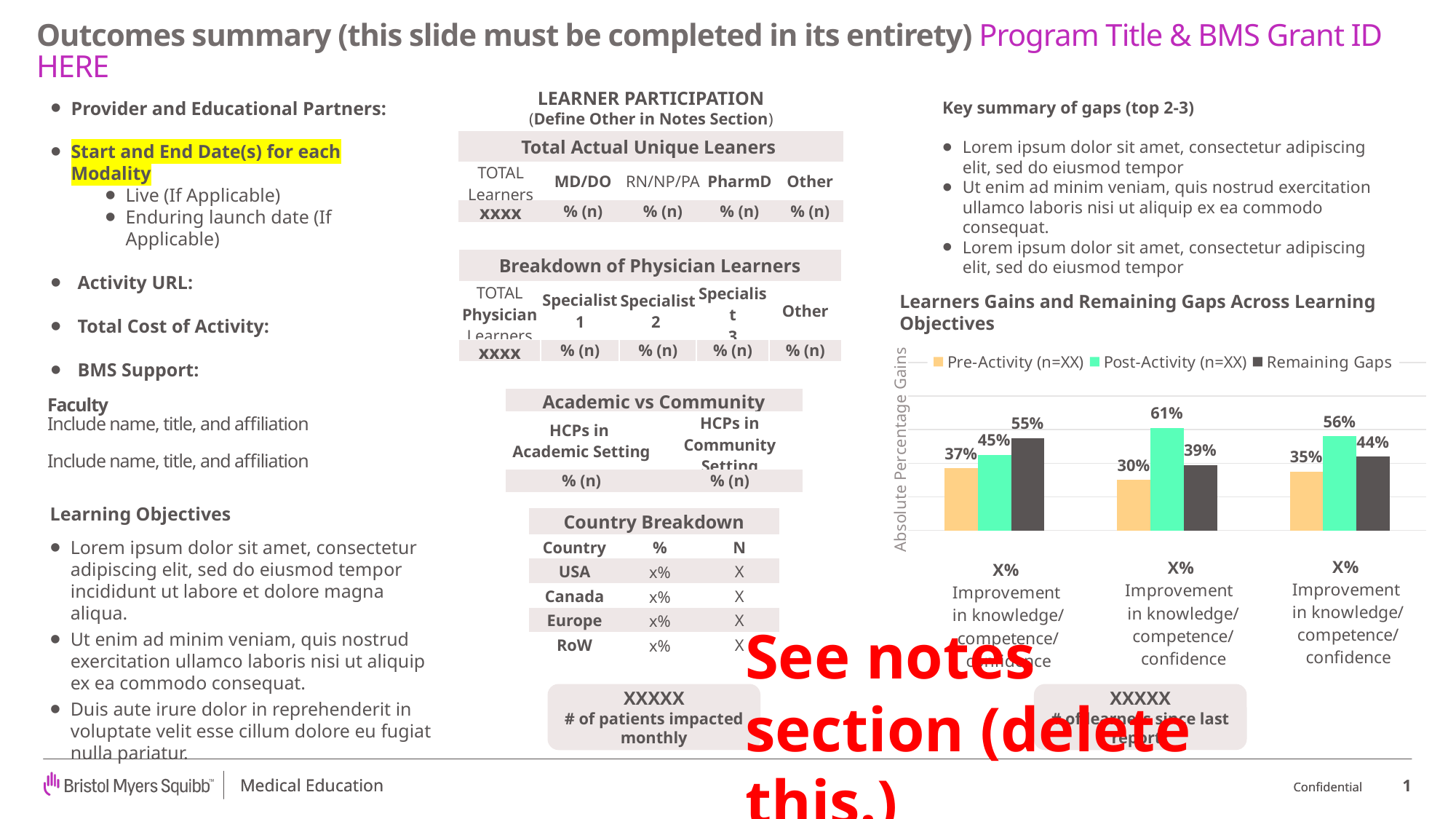
In the 'Learners Gains and Remaining Gaps' chart, what is the difference between the Post-Activity and Pre-Activity values for the middle group? 31% In the 'Learners Gains and Remaining Gaps' chart, which learning objective group has the highest Post-Activity value? the second (middle) group How many series does the legend of the 'Learners Gains and Remaining Gaps Across Learning Objectives' chart list? 3 In the 'Learners Gains and Remaining Gaps' chart, what is the Remaining Gaps value for the third learning objective (rightmost group)? 44% In the 'Learners Gains and Remaining Gaps' chart, which learning objective group has the lowest Pre-Activity value? the second (middle) group In the 'Learners Gains and Remaining Gaps' chart, what is the Post-Activity value for the second learning objective (middle group)? 61% In the 'Learners Gains and Remaining Gaps' chart, which is larger for the leftmost group: the Post-Activity value or the Remaining Gaps value? Remaining Gaps What is the y-axis label of the 'Learners Gains and Remaining Gaps Across Learning Objectives' chart? Absolute Percentage Gains How many groups of bars (learning objectives) are plotted in the 'Learners Gains and Remaining Gaps Across Learning Objectives' chart? 3 In the 'Learners Gains and Remaining Gaps' chart, what is the difference between the Remaining Gaps values of the first and second groups? 16% In the 'Learners Gains and Remaining Gaps' chart, what is the Pre-Activity value for the first learning objective (leftmost group)? 37% What type of chart is shown under the title 'Learners Gains and Remaining Gaps Across Learning Objectives'? bar chart